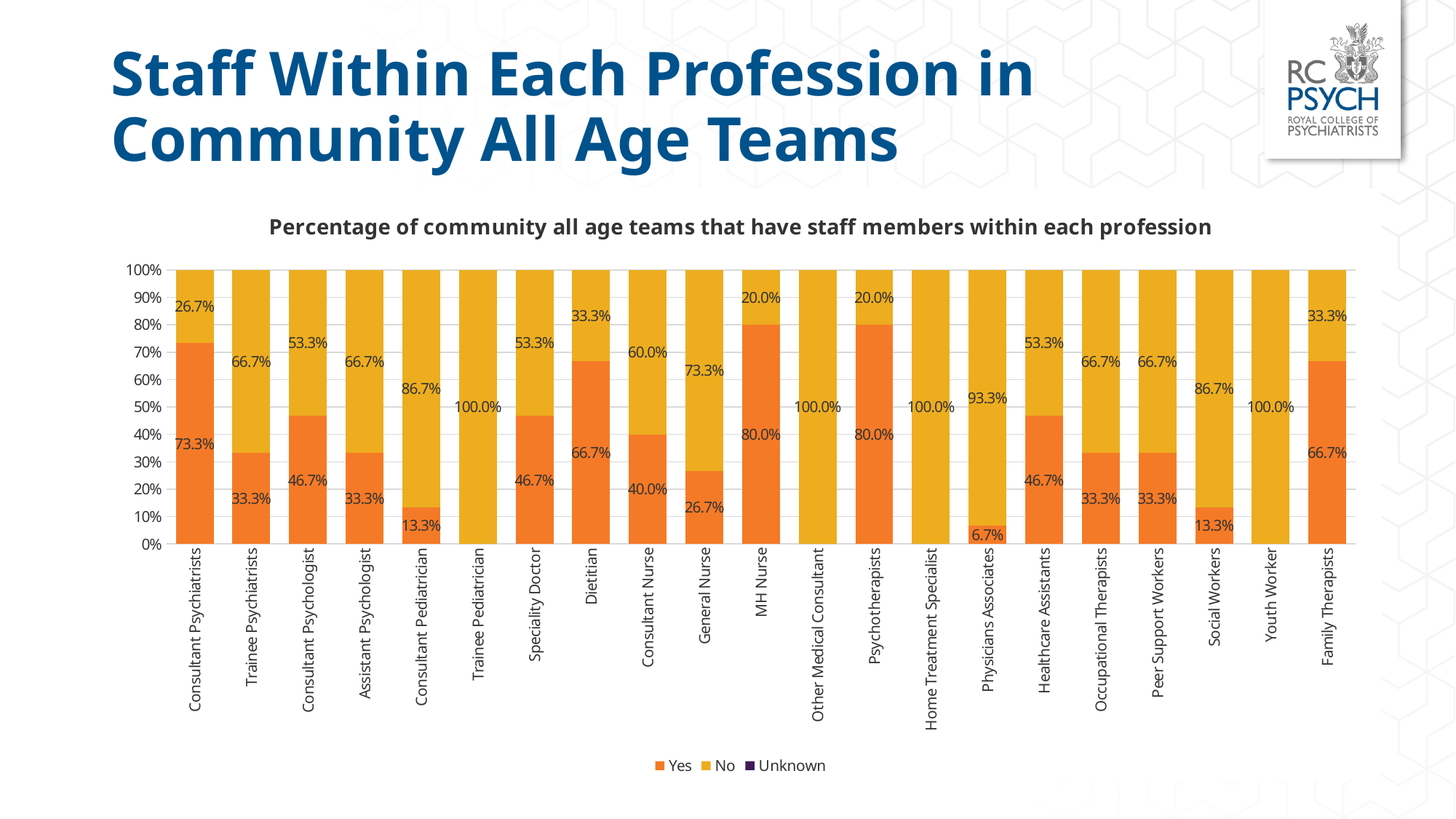
What is the "Yes" value for Physicians Associates? 6.7% What is the total of the stacked bar for Healthcare Assistants? 100% Which has a larger "Yes" value, Consultant Psychologist or General Nurse? Consultant Psychologist Which has a larger "No" value, Social Workers or Family Therapists? Social Workers What is the "No" value for Consultant Pediatrician? 86.7% What kind of chart is shown on the slide? Stacked bar chart How many series does the legend list? 3 What is the "No" value for Trainee Pediatrician? 100.0% How many professions are shown on the x axis? 21 What is the "Yes" value for MH Nurse? 80.0% What is the difference between the "Yes" values for Dietitian and Consultant Nurse? 26.7% What is the "Yes" value for Consultant Psychiatrists? 73.3%